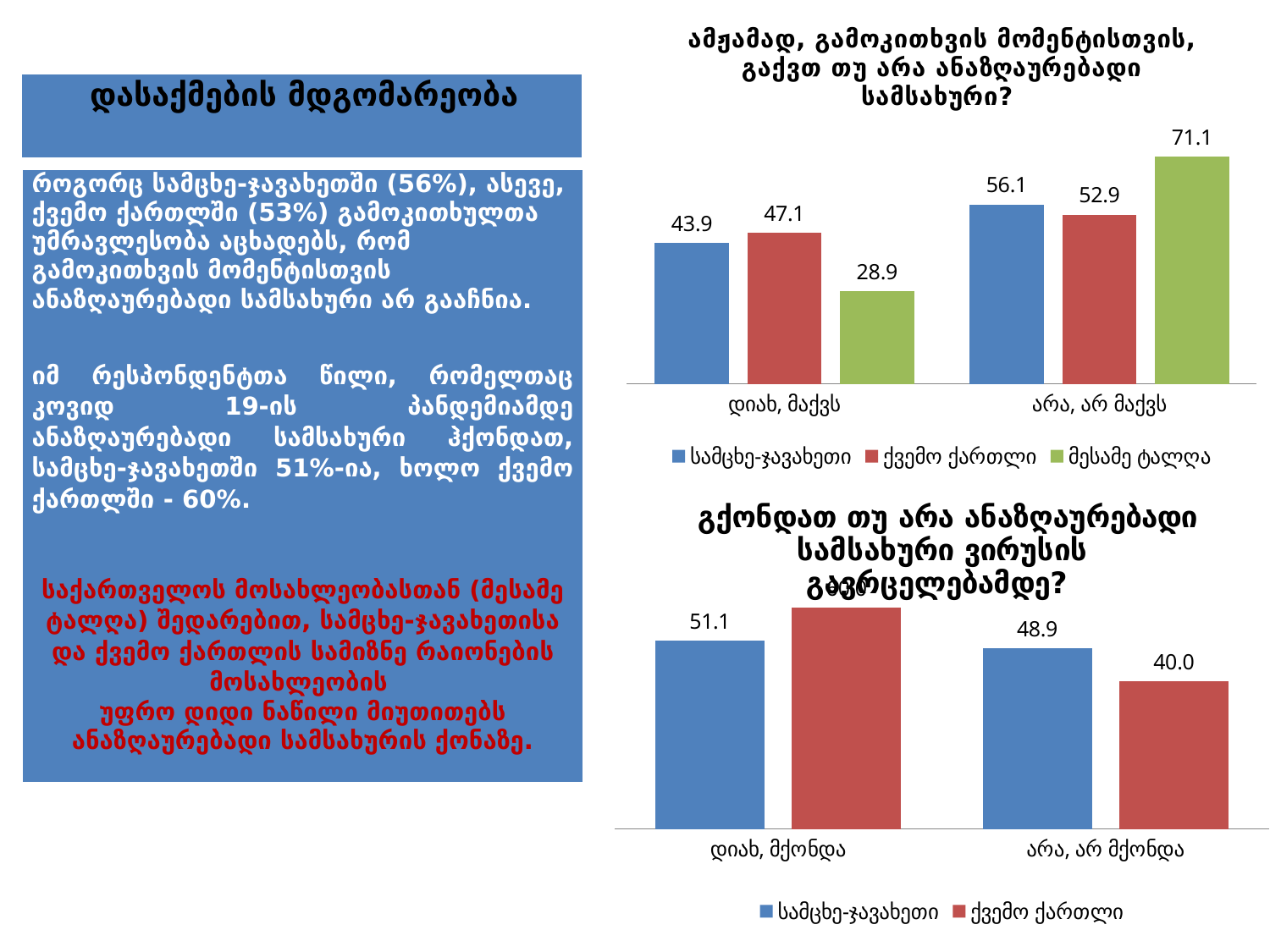
In the bottom chart, what is the value for ქვემო ქართლი in the category არა, არ მქონდა? 40.0 In the top chart, what is the value for მესამე ტალღა in the category არა, არ მაქვს? 71.1 In the top chart, which series has the highest value in the category არა, არ მაქვს? მესამე ტალღა In the top chart, what is the value for ქვემო ქართლი in the category არა, არ მაქვს? 52.9 In the top chart, what is the value for სამცხე-ჯავახეთი in the category დიახ, მაქვს? 43.9 What kind of chart is the top chart on the slide? Bar chart In the top chart, which series has the lowest value in the category დიახ, მაქვს? მესამე ტალღა In the bottom chart, how many series does the legend list? 2 In the bottom chart, what is the value for სამცხე-ჯავახეთი in the category დიახ, მქონდა? 51.1 In the top chart, how many series does the legend list? 3 In the top chart, what is the difference between the values for სამცხე-ჯავახეთი and ქვემო ქართლი in the category დიახ, მაქვს? 3.2 In the bottom chart, which series has the larger value in the category არა, არ მქონდა: სამცხე-ჯავახეთი or ქვემო ქართლი? სამცხე-ჯავახეთი